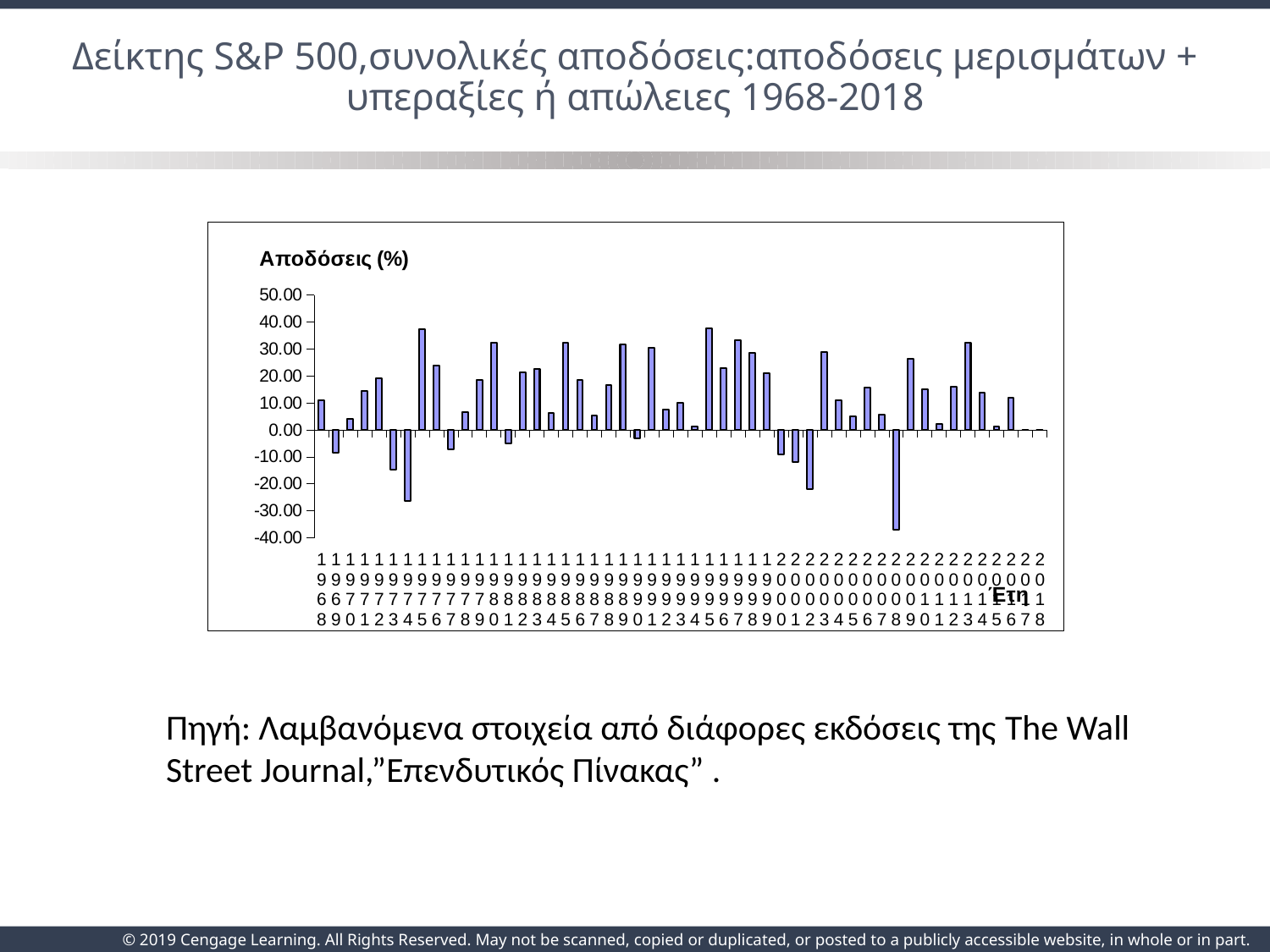
Which year has the lower return, 2002 or 2008? 2008 Is the return for 1980 greater or less than 30? greater Is the return for 1997 greater or less than 30? greater Is the return for 1974 greater or less than -20? less What is the label on the vertical axis of the chart? Αποδόσεις (%) What kind of chart is shown on the slide? bar chart Which year has the larger return, 1976 or 1980? 1980 How many years (bars) are plotted in the chart? 51 What is the label on the horizontal axis of the chart? Έτη Which year has the lowest return in the chart? 2008